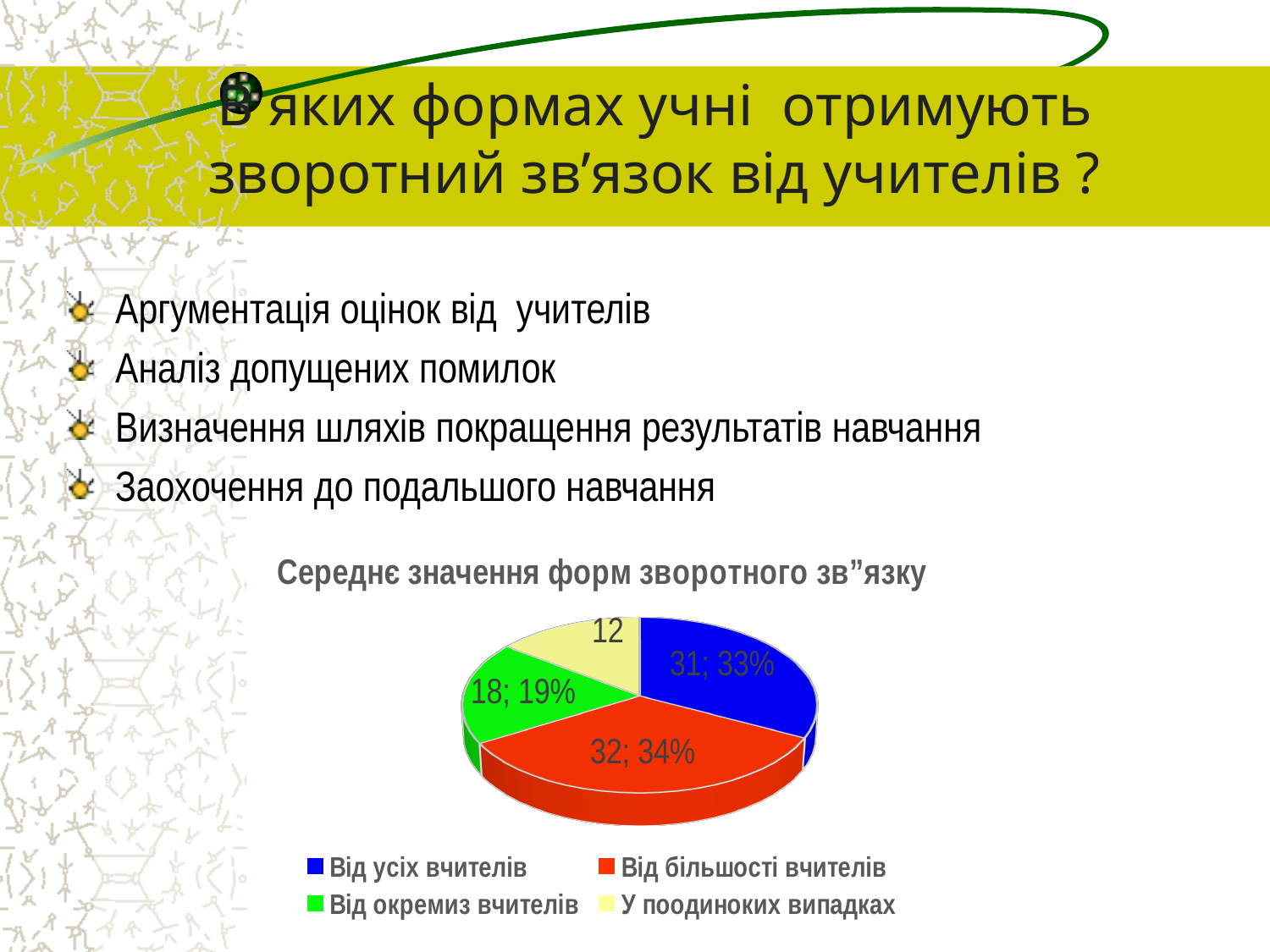
What is the difference between the values for "Від більшості вчителів" and "Від окремиз вчителів"? 14 Which category has the smallest slice of the pie? У поодиноких випадках What share of the pie does "Від окремиз вчителів" represent? 19% What is the value for "Від більшості вчителів"? 32 What is the title of the chart? Середнє значення форм зворотного зв”язку What is the value for "Від усіх вчителів"? 31 What type of chart is shown on the slide? pie chart How many slices does the pie chart have? 4 How many entries does the chart legend list? 4 Which category has the largest slice of the pie? Від більшості вчителів What is the value for "Від окремиз вчителів"? 18